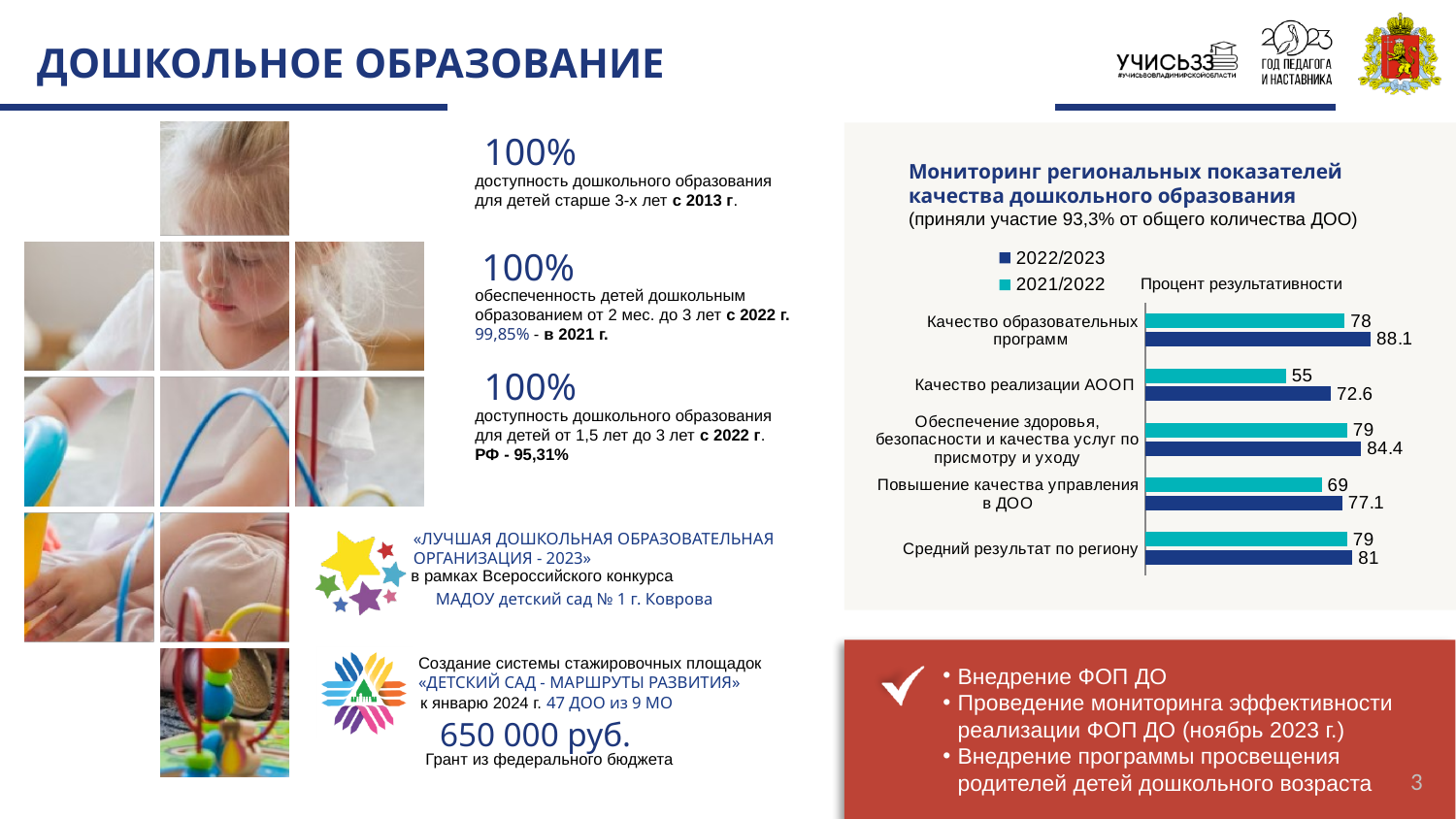
How many categories are plotted on the chart? 5 What is the 2022/2023 value for «Качество образовательных программ»? 88.1 What is the 2021/2022 value for «Качество реализации АООП»? 55 For «Обеспечение здоровья, безопасности и качества услуг по присмотру и уходу», which is larger: the 2022/2023 value or the 2021/2022 value? 2022/2023 What share of ДОО took part in the monitoring, according to the chart subtitle? 93,3% What is the difference between the 2022/2023 and 2021/2022 values for «Качество реализации АООП»? 17.6 Which category has the lowest 2021/2022 value? Качество реализации АООП What is the 2021/2022 value for «Повышение качества управления в ДОО»? 69 How many series does the legend of the chart list? 2 Which category has the highest 2022/2023 value? Качество образовательных программ What is the 2022/2023 value for «Средний результат по региону»? 81 What type of chart is shown under the title «Мониторинг региональных показателей качества дошкольного образования»? bar chart